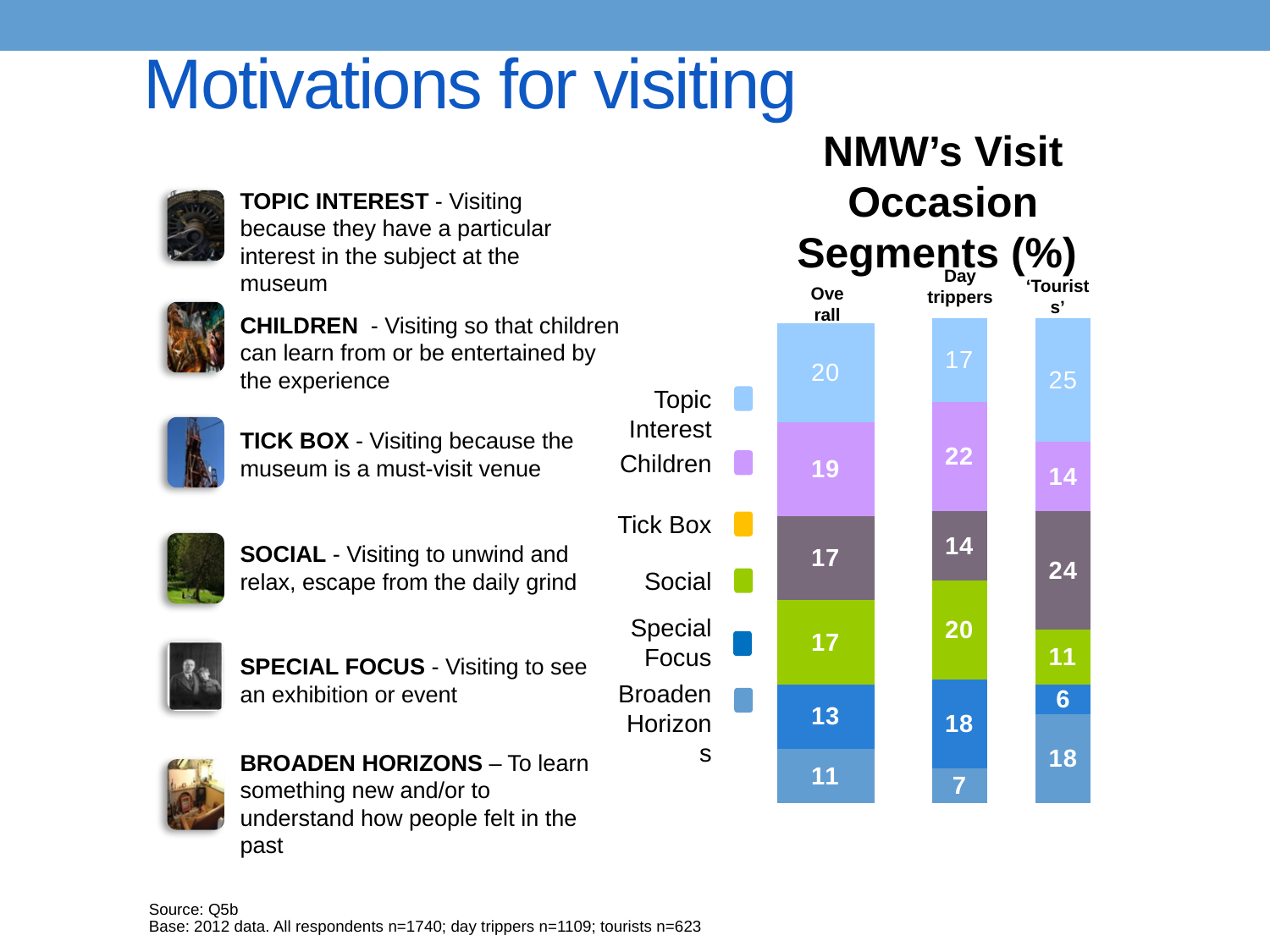
What is the Social value for Day trippers? 20 Which segment has the lowest Broaden Horizons value? Day trippers What is the Children value for Day trippers? 22 What is the Special Focus value for 'Tourists'? 6 What is the Topic Interest value for the Overall bar? 20 How many segment bars are plotted in the chart? 3 What is the Broaden Horizons value for 'Tourists'? 18 How many series does the legend list? 6 What is the total of the Overall stacked bar? 97 What kind of chart is shown on the slide? Stacked bar chart What is the difference between the Topic Interest values for 'Tourists' and Day trippers? 8 Which has the larger Children value, Overall or 'Tourists'? Overall